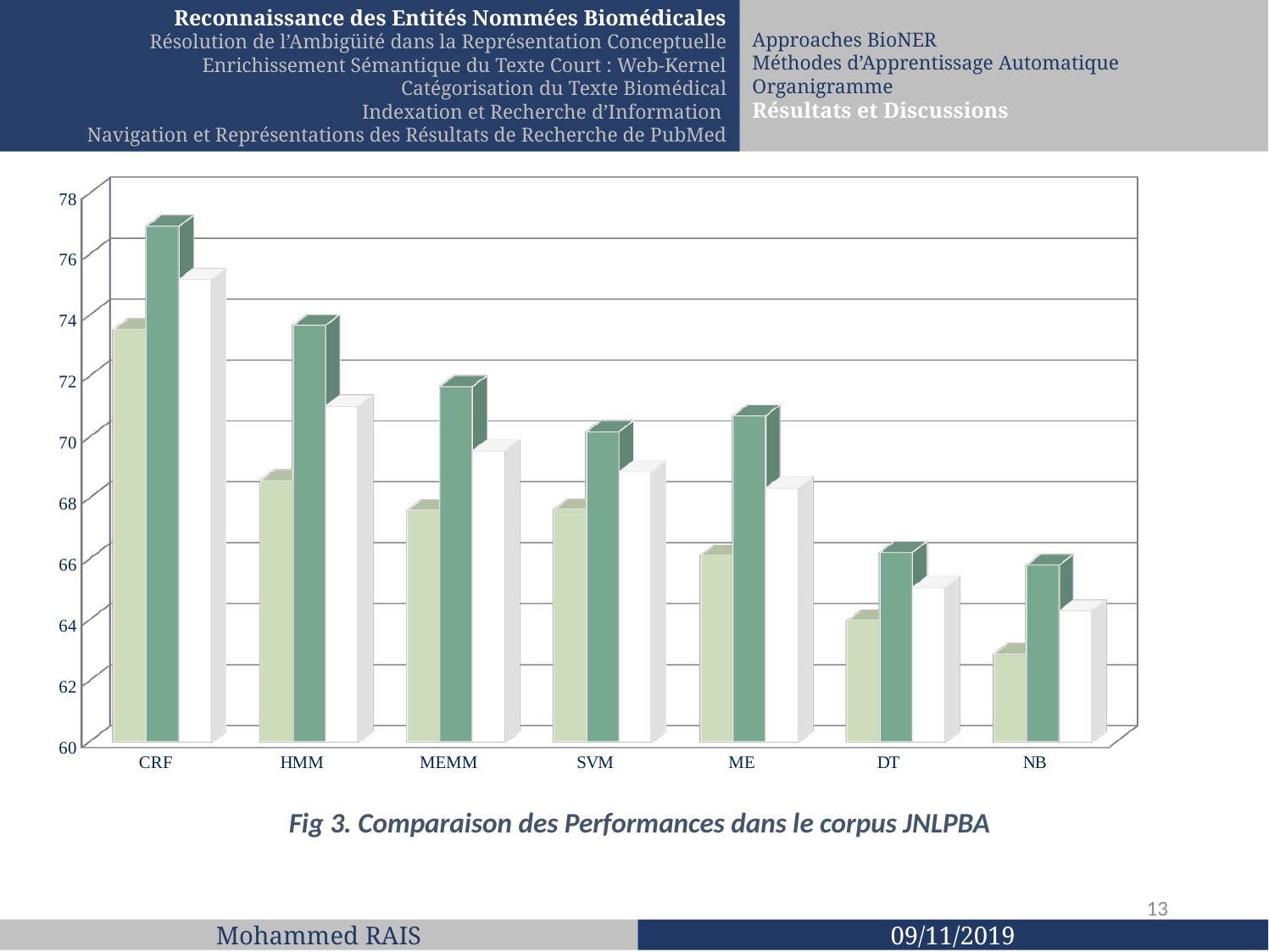
Which has the larger dark green bar, CRF or NB? CRF How many bars are plotted for each category in the chart? 3 Is the value of the dark green bar for CRF greater or less than 76? greater Is the value of the dark green bar for HMM greater or less than 72? greater What kind of chart is shown on the slide? bar chart Which category has the tallest bar in the chart? CRF Which category has the shortest bar in the chart? NB Is the value of the light green bar for ME greater or less than 68? less Which has the larger light green bar, HMM or DT? HMM What is the caption of the figure shown on the slide? Fig 3. Comparaison des Performances dans le corpus JNLPBA How many categories are shown on the x axis of the chart? 7